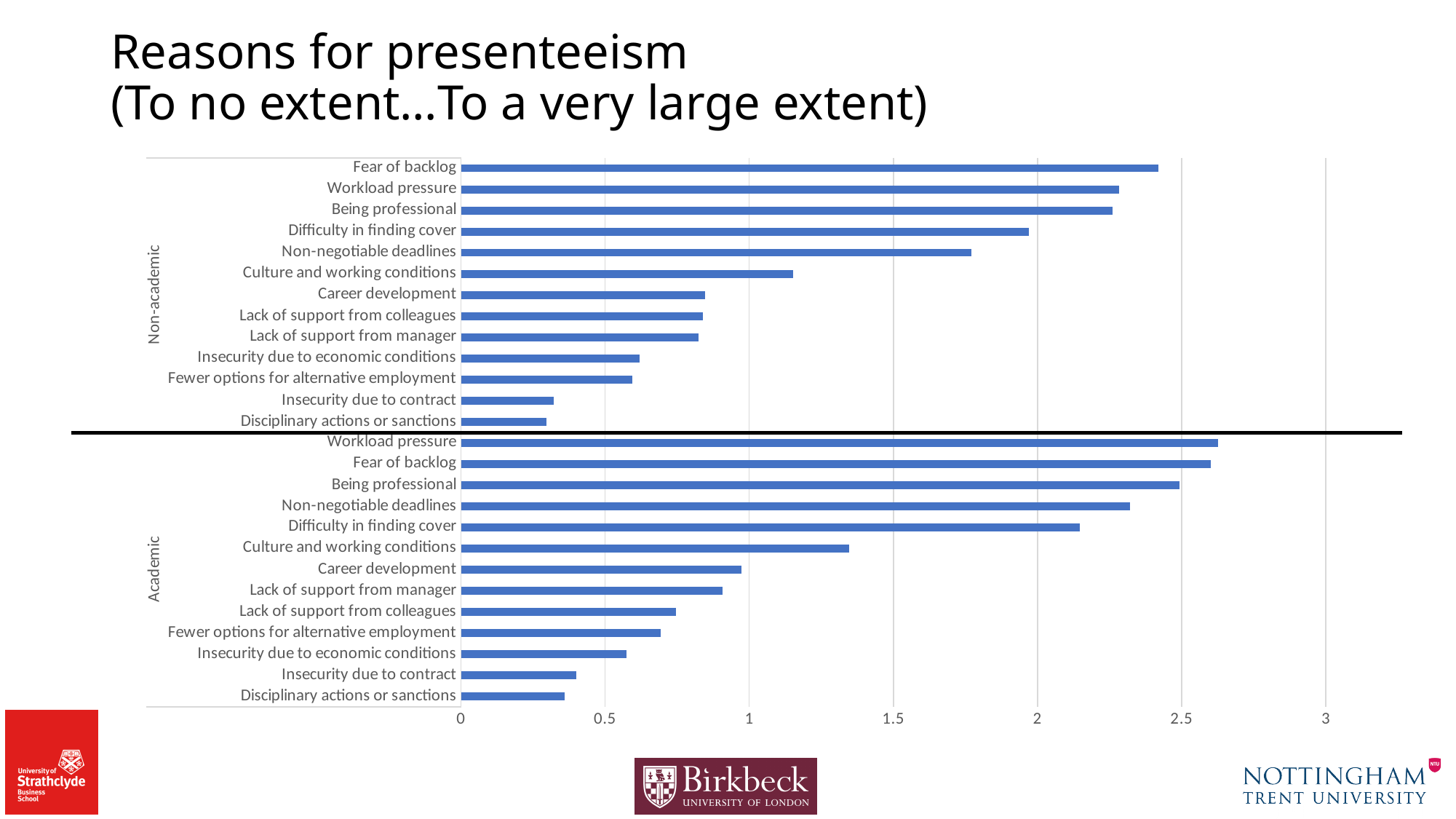
How many bars are plotted in total across both groups? 26 What kind of chart is shown on the slide? Bar chart Is the value for Non-negotiable deadlines in the Non-academic group greater or less than 2? less Is the value for Disciplinary actions or sanctions in the Non-academic group greater or less than 0.5? less How many reasons are listed in the Non-academic group? 13 What are the two groups into which the bars are divided? Non-academic and Academic Which reason has the highest value in the Non-academic group? Fear of backlog Which is larger: Culture and working conditions for the Academic group or for the Non-academic group? Academic Is the value for Difficulty in finding cover in the Academic group greater or less than 2? greater What is the title of the slide? Reasons for presenteeism (To no extent…To a very large extent) Which is larger: Workload pressure for the Academic group or Workload pressure for the Non-academic group? Academic